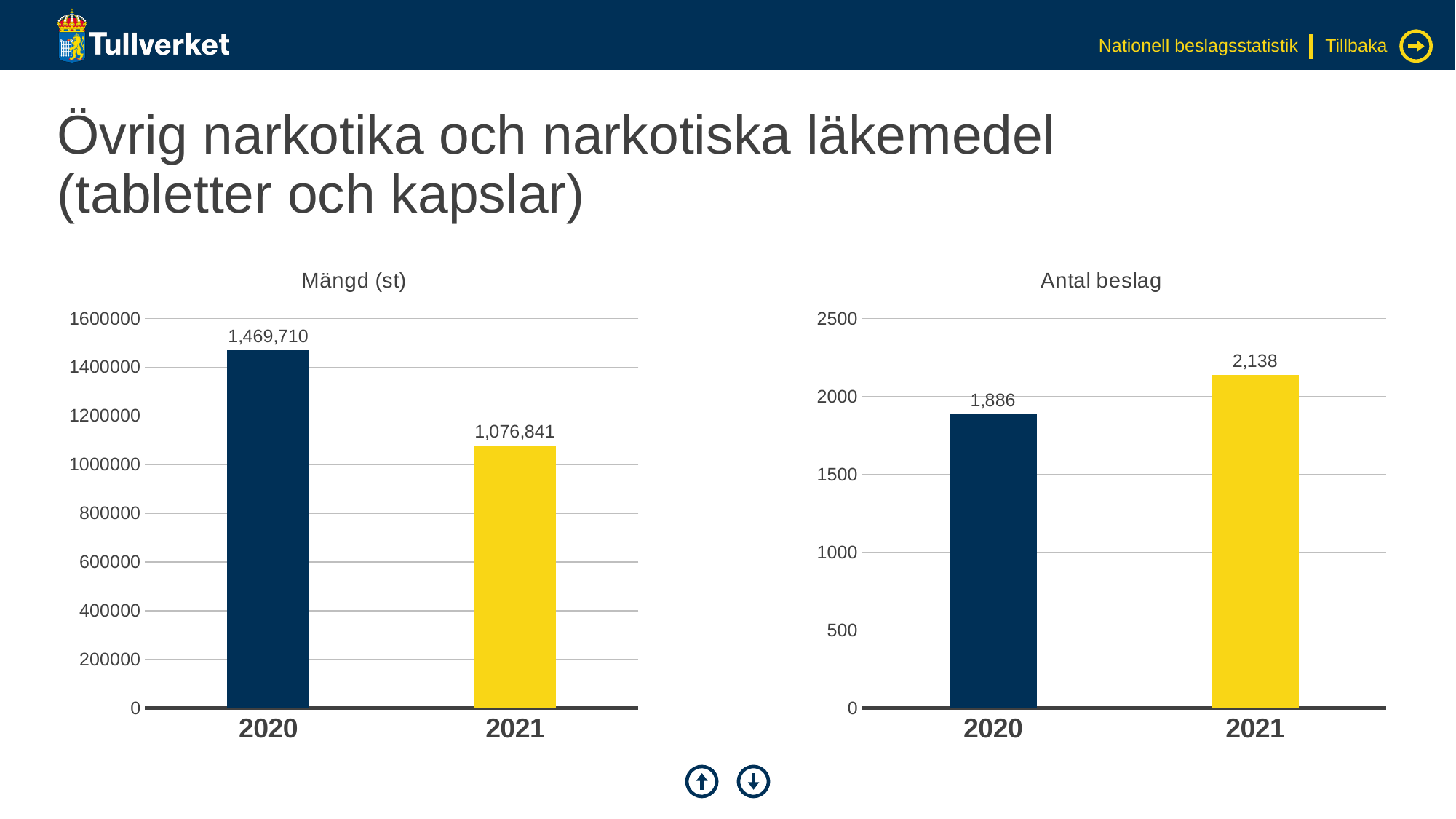
In the 'Antal beslag' chart, what is the value for 2021? 2,138 In the 'Mängd (st)' chart, do the values rise or fall from 2020 to 2021? fall In the 'Antal beslag' chart, is the value for 2021 greater or less than 2000? greater In the 'Antal beslag' chart, which year has the lowest value? 2020 In the 'Mängd (st)' chart, which year has the highest value? 2020 In the 'Mängd (st)' chart, what is the value for 2021? 1,076,841 In the 'Antal beslag' chart, what is the difference between the 2021 and 2020 values? 252 What kind of chart is the 'Mängd (st)' chart? bar chart In the 'Mängd (st)' chart, what is the value for 2020? 1,469,710 In the 'Mängd (st)' chart, what is the difference between the 2020 and 2021 values? 392,869 How many categories are shown on the x axis of the 'Antal beslag' chart? 2 In the 'Antal beslag' chart, what is the value for 2020? 1,886